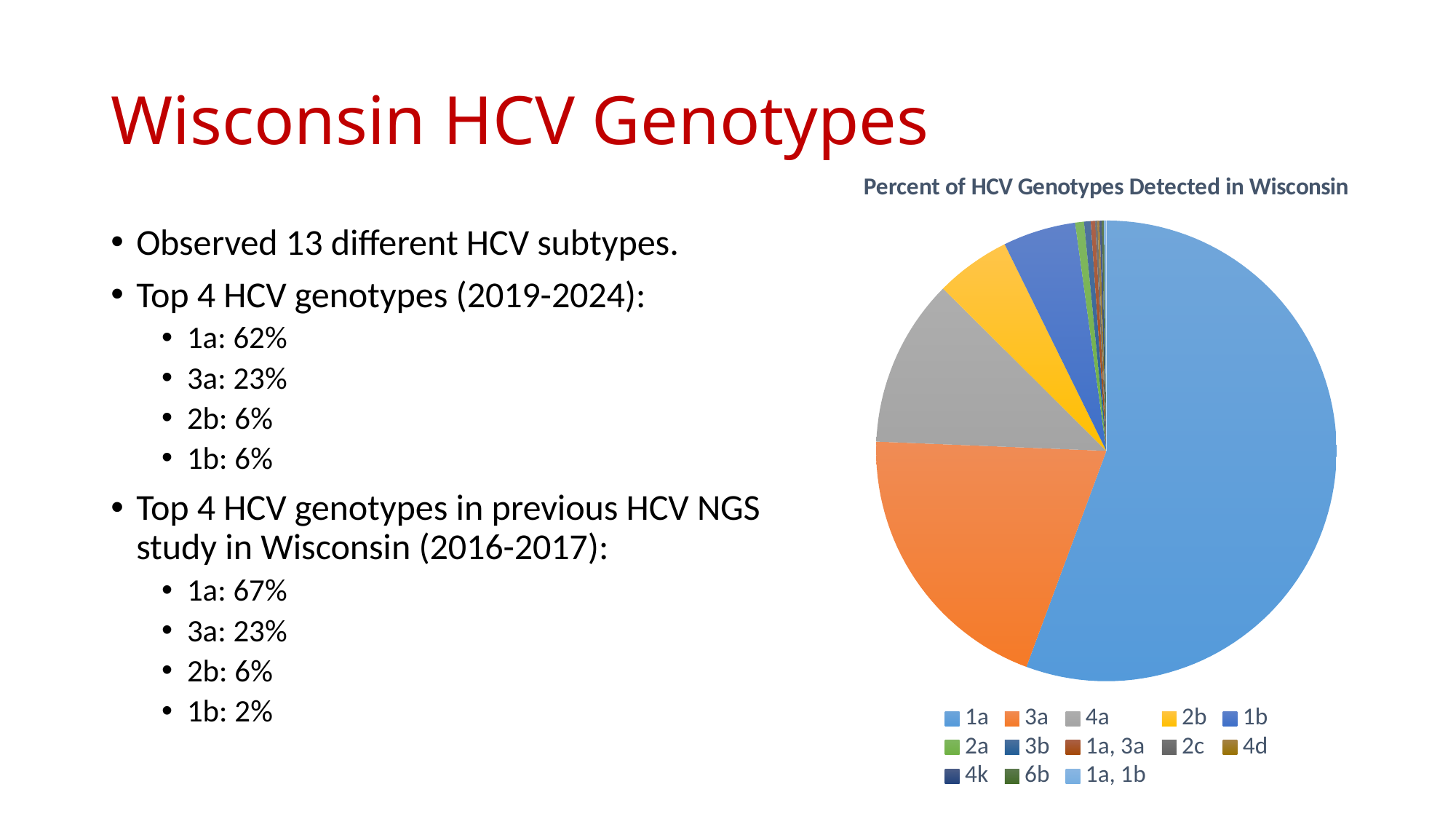
Which genotype has the largest slice of the pie? 1a Which slice is larger, 4a or 2b? 4a Does the 1a slice take up more or less than half of the pie? more Which genotype has the second-largest slice of the pie? 3a What kind of chart is shown on the slide? pie chart Which slice is larger, 2b or 3a? 3a Which slice is larger, 1a or 3a? 1a What is the title of the chart? Percent of HCV Genotypes Detected in Wisconsin Does the 3a slice take up more or less than half of the pie? less How many genotype categories does the chart's legend list? 13